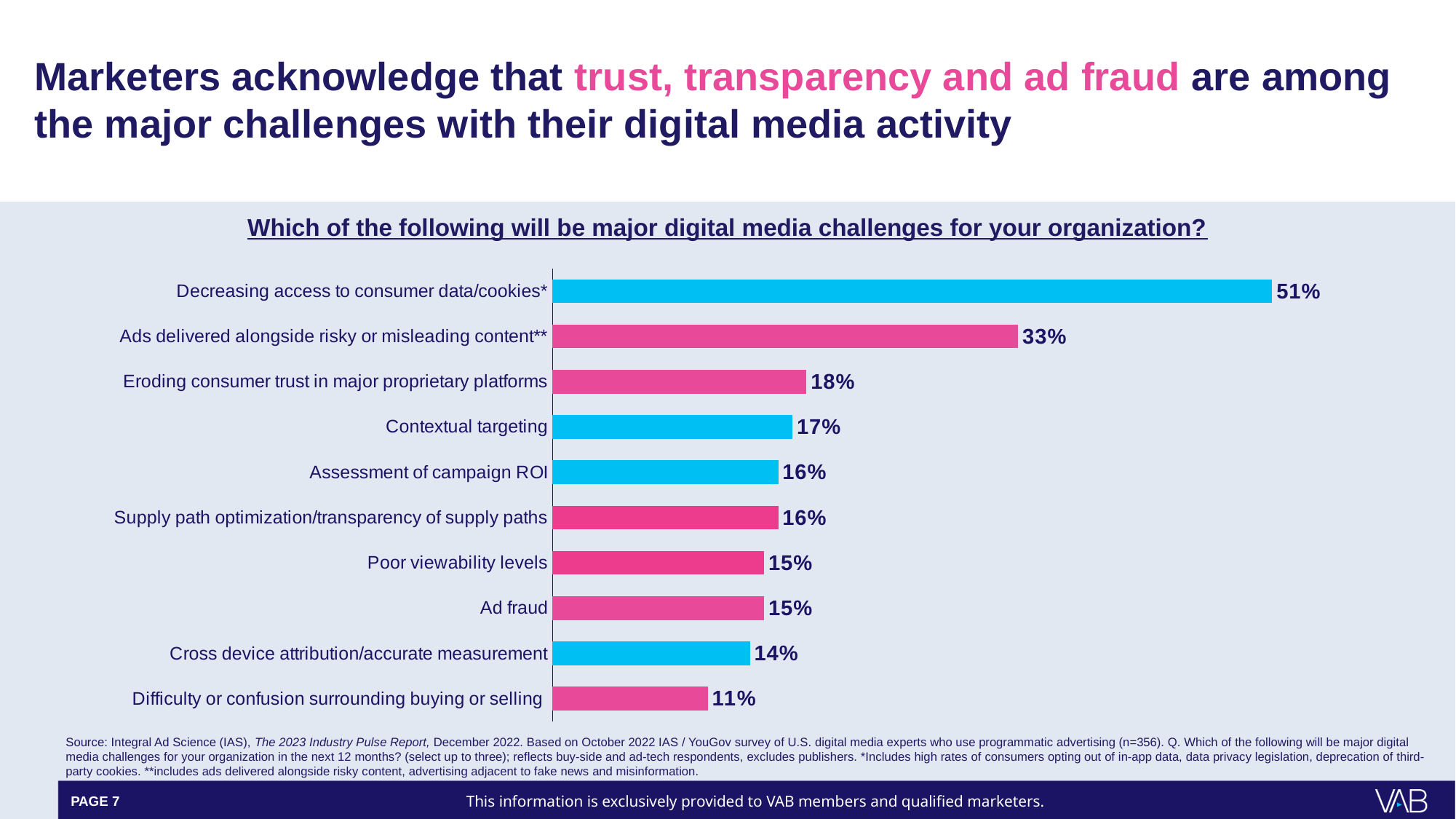
How many challenge categories are shown in the chart? 10 What is the value shown for 'Ad fraud'? 15% What is the title of the chart? Which of the following will be major digital media challenges for your organization? Which is larger: the value for 'Ads delivered alongside risky or misleading content**' or the value for 'Eroding consumer trust in major proprietary platforms'? Ads delivered alongside risky or misleading content** What is the difference between 'Eroding consumer trust in major proprietary platforms' and 'Cross device attribution/accurate measurement'? 4 percentage points What type of chart is used on this slide? Bar chart Which challenge has the lowest percentage in the chart? Difficulty or confusion surrounding buying or selling What is the difference in percentage points between 'Decreasing access to consumer data/cookies*' and 'Ads delivered alongside risky or misleading content**'? 18 percentage points What is the value shown for 'Contextual targeting'? 17% Which challenge has the highest percentage in the chart? Decreasing access to consumer data/cookies* What colour is the bar for 'Ads delivered alongside risky or misleading content**'? Pink What percentage of respondents cited 'Decreasing access to consumer data/cookies*' as a major digital media challenge? 51%